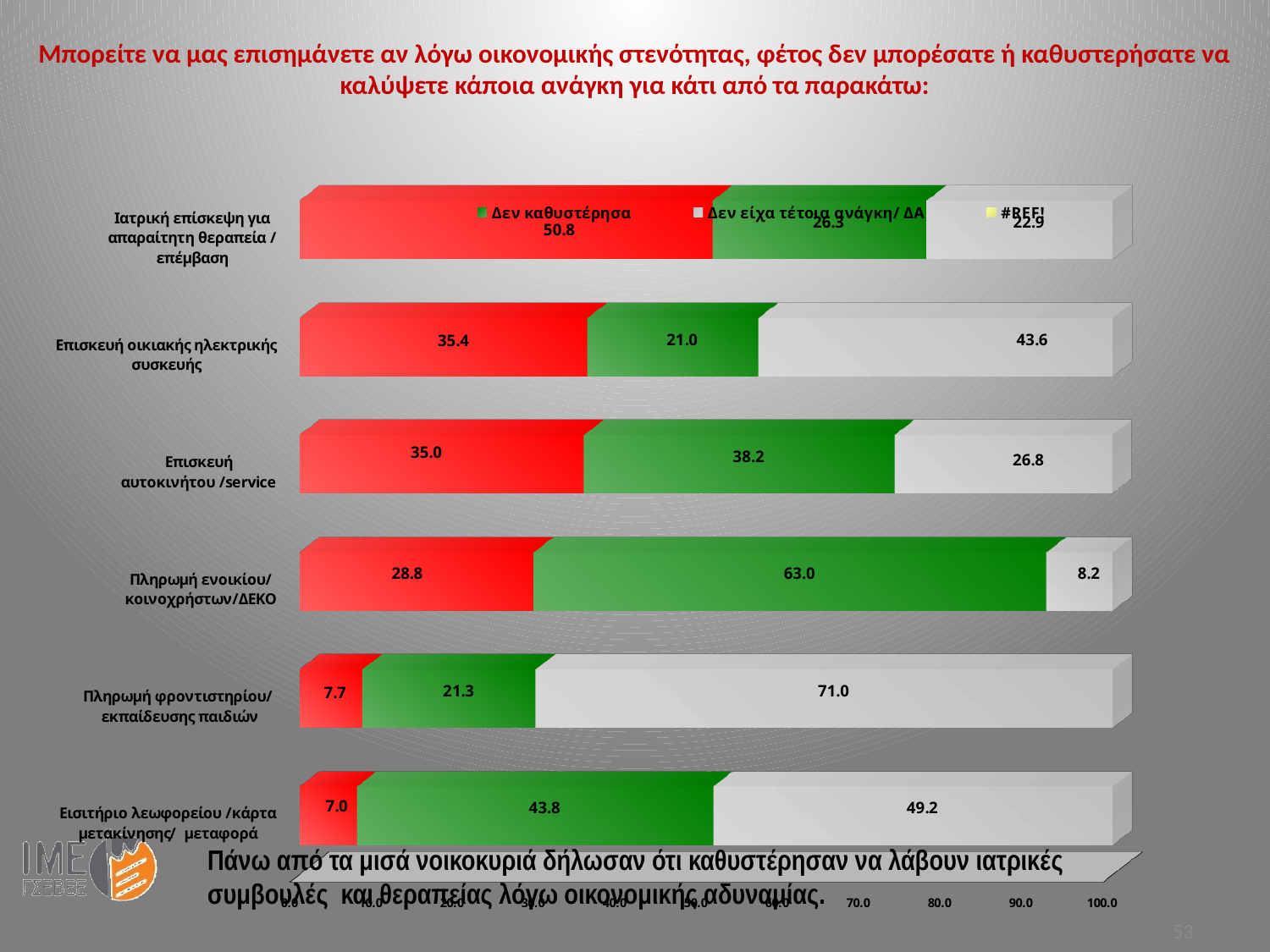
What is the 'Δεν είχα τέτοια ανάγκη/ ΔΑ' (grey) value for 'Πληρωμή φροντιστηρίου/εκπαίδευσης παιδιών'? 71.0 What is the total of the three segments for 'Επισκευή οικιακής ηλεκτρικής συσκευής'? 100.0 Which is larger for 'Επισκευή αυτοκινήτου /service': the red segment or the green 'Δεν καθυστέρησα' segment? green 'Δεν καθυστέρησα' (38.2) What is the value of the red segment for 'Ιατρική επίσκεψη για απαραίτητη θεραπεία / επέμβαση'? 50.8 What kind of chart is shown on the slide? bar chart What is the 'Δεν καθυστέρησα' (green) value for 'Πληρωμή ενοικίου/κοινοχρήστων/ΔΕΚΟ'? 63.0 Which category has the lowest 'Δεν είχα τέτοια ανάγκη/ ΔΑ' (grey) value? Πληρωμή ενοικίου/κοινοχρήστων/ΔΕΚΟ Which category has the highest red segment value? Ιατρική επίσκεψη για απαραίτητη θεραπεία / επέμβαση How many categories (needs) are plotted on the chart? 6 What is the red segment value for 'Εισιτήριο λεωφορείου /κάρτα μετακίνησης/ μεταφορά'? 7.0 What is the difference between the green (63.0) and red (28.8) values for 'Πληρωμή ενοικίου/κοινοχρήστων/ΔΕΚΟ'? 34.2 What colour represents the 'Δεν καθυστέρησα' series in the legend? green